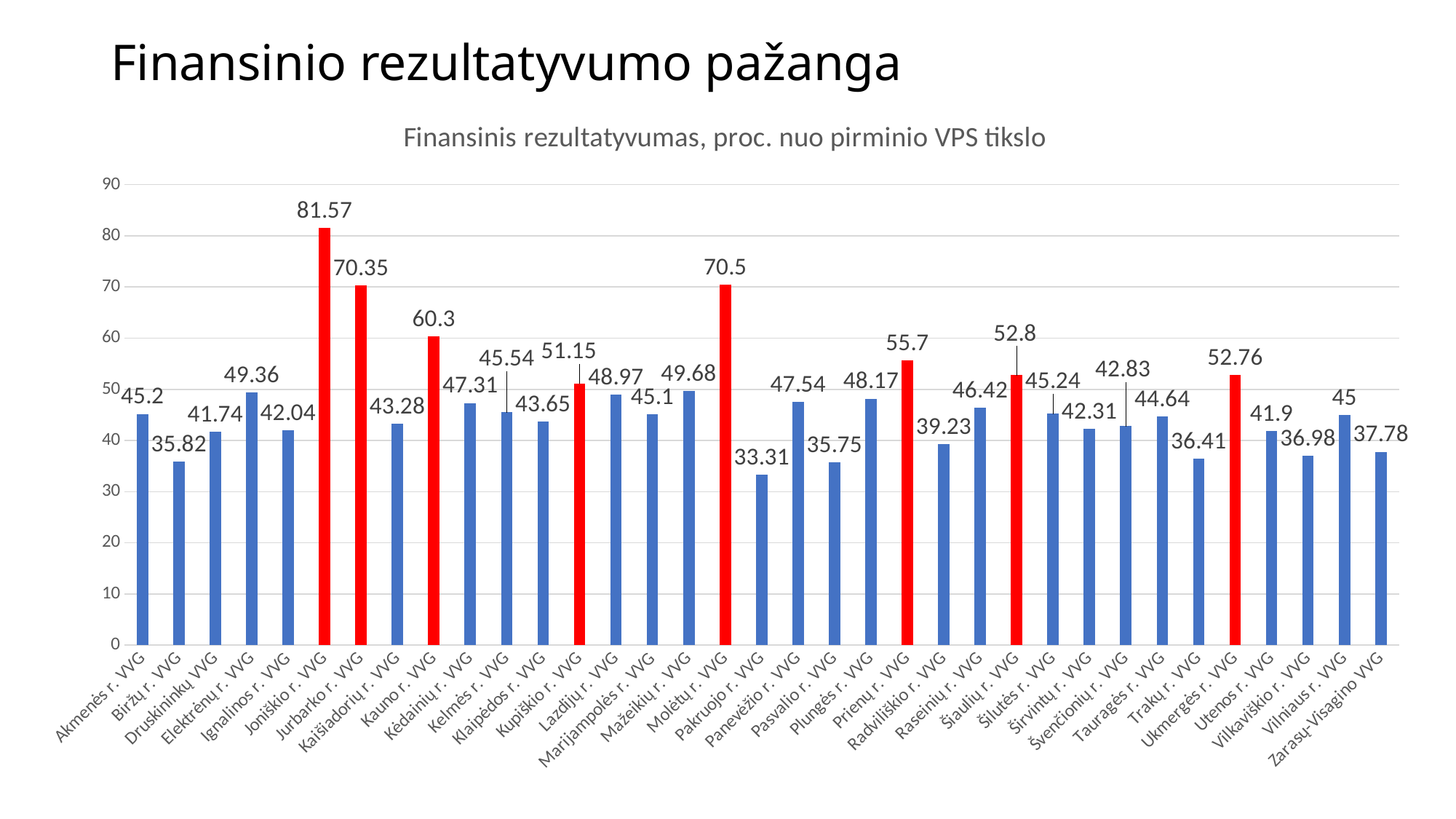
How many categories are shown on the x axis? 35 Which category has the highest value? Joniškio r. VVG What is the difference between the values for Molėtų r. VVG and Kauno r. VVG? 10.2 Which category has the lowest value? Pakruojo r. VVG Which is larger, the value for Prienų r. VVG or Šiaulių r. VVG? Prienų r. VVG What is the value for Joniškio r. VVG? 81.57 What kind of chart is shown on the slide? bar chart What is the value for Vilniaus r. VVG? 45 What is the difference between the values for Joniškio r. VVG and Jurbarko r. VVG? 11.22 What is the title of the chart? Finansinis rezultatyvumas, proc. nuo pirminio VPS tikslo What is the value for Pakruojo r. VVG? 33.31 Is the value for Pakruojo r. VVG greater or less than 40? less